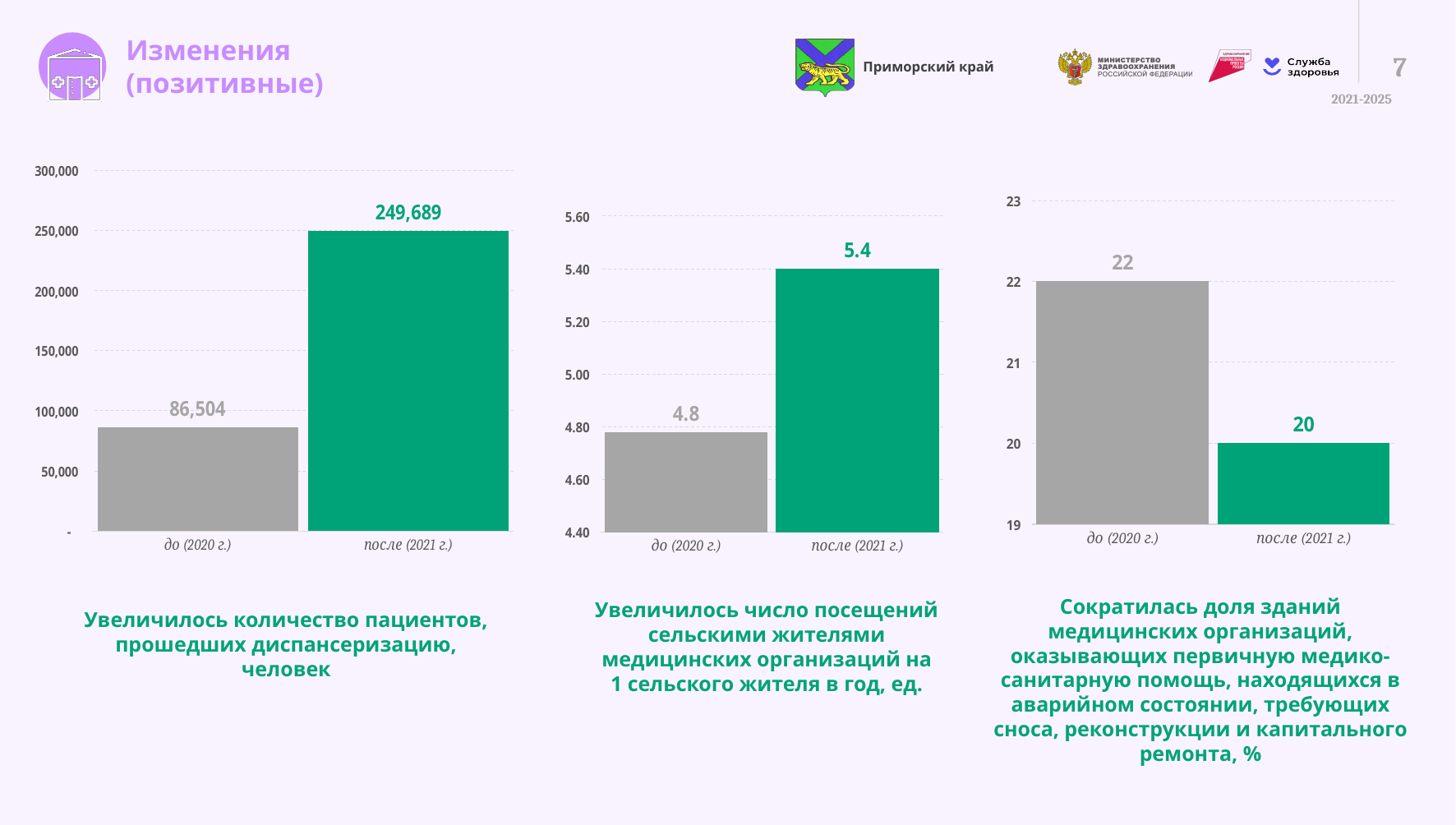
In the left chart (patients who underwent dispensary examination), what is the difference between the 'после (2021 г.)' and 'до (2020 г.)' values? 163,185 In the right chart (share of medical buildings in emergency condition, %), which category has the lowest value? после (2021 г.) In the middle chart (visits per rural resident per year), which category has the higher value? после (2021 г.) How many categories does the left chart (patients who underwent dispensary examination) show? 2 In the middle chart (visits per rural resident per year), what is the value for 'после (2021 г.)'? 5.4 In the right chart (share of medical buildings in emergency condition, %), do the values rise or fall from 'до (2020 г.)' to 'после (2021 г.)'? fall In the left chart (patients who underwent dispensary examination), what is the value for 'до (2020 г.)'? 86,504 In the left chart (patients who underwent dispensary examination), what is the value for 'после (2021 г.)'? 249,689 In the middle chart (visits per rural resident per year), what is the value for 'до (2020 г.)'? 4.8 In the right chart (share of medical buildings in emergency condition, %), what is the value for 'до (2020 г.)'? 22 What type of chart is the middle chart (visits per rural resident per year)? bar chart In the right chart (share of medical buildings in emergency condition, %), what is the value for 'после (2021 г.)'? 20